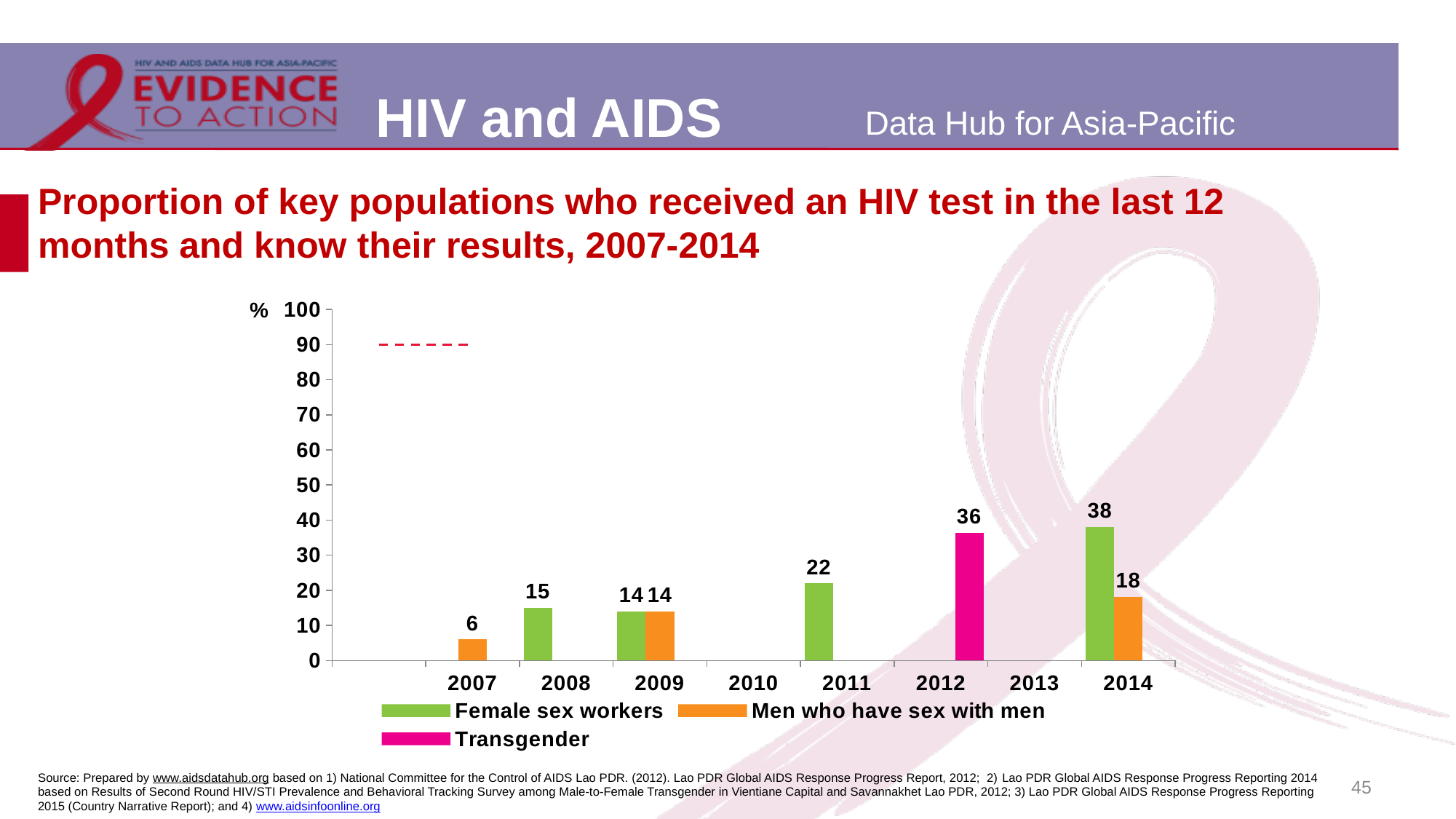
How many series does the legend list? 3 What kind of chart is shown on the slide? bar chart In which year is the value for Female sex workers highest? 2014 Do the Female sex workers values rise or fall from 2008 to 2014? rise What is the value for Transgender in 2012? 36 What is the difference between the Female sex workers value and the Men who have sex with men value in 2014? 20 Is the value for Transgender in 2012 greater or less than 30? greater What is the value for Men who have sex with men in 2007? 6 How many years are shown on the x axis? 8 Which is larger: the Female sex workers value in 2011 or in 2008? 2011 What is the value for Female sex workers in 2014? 38 What is the value for Men who have sex with men in 2009? 14